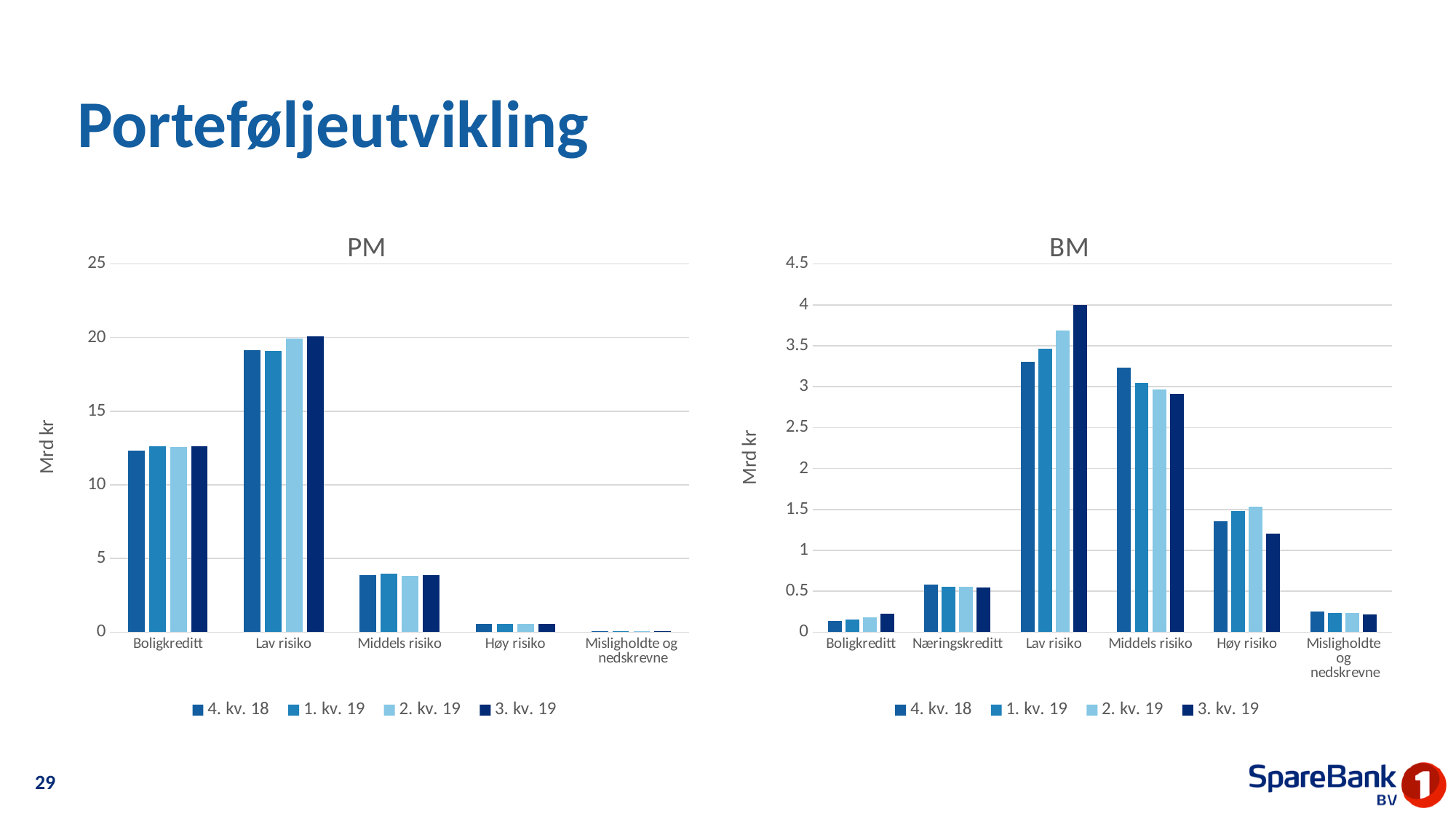
In the PM chart, which category has the lowest values? Misligholdte og nedskrevne How many categories are shown on the x axis of the PM chart? 5 How many categories are shown on the x axis of the BM chart? 6 In the BM chart, is the value for Middels risiko in 4. kv. 18 greater or less than 3? greater What is the y-axis label of the BM chart? Mrd kr In the BM chart, which category has the lowest values? Boligkreditt In the PM chart, is the value for Middels risiko in 4. kv. 18 greater or less than 5? less In the PM chart, which category has the highest values? Lav risiko What kind of chart is the PM chart? bar chart In the PM chart, is the value for Boligkreditt in 3. kv. 19 greater or less than 10? greater How many series does the legend of the BM chart list? 4 In the BM chart, do the values for Lav risiko rise or fall from 4. kv. 18 to 3. kv. 19? rise